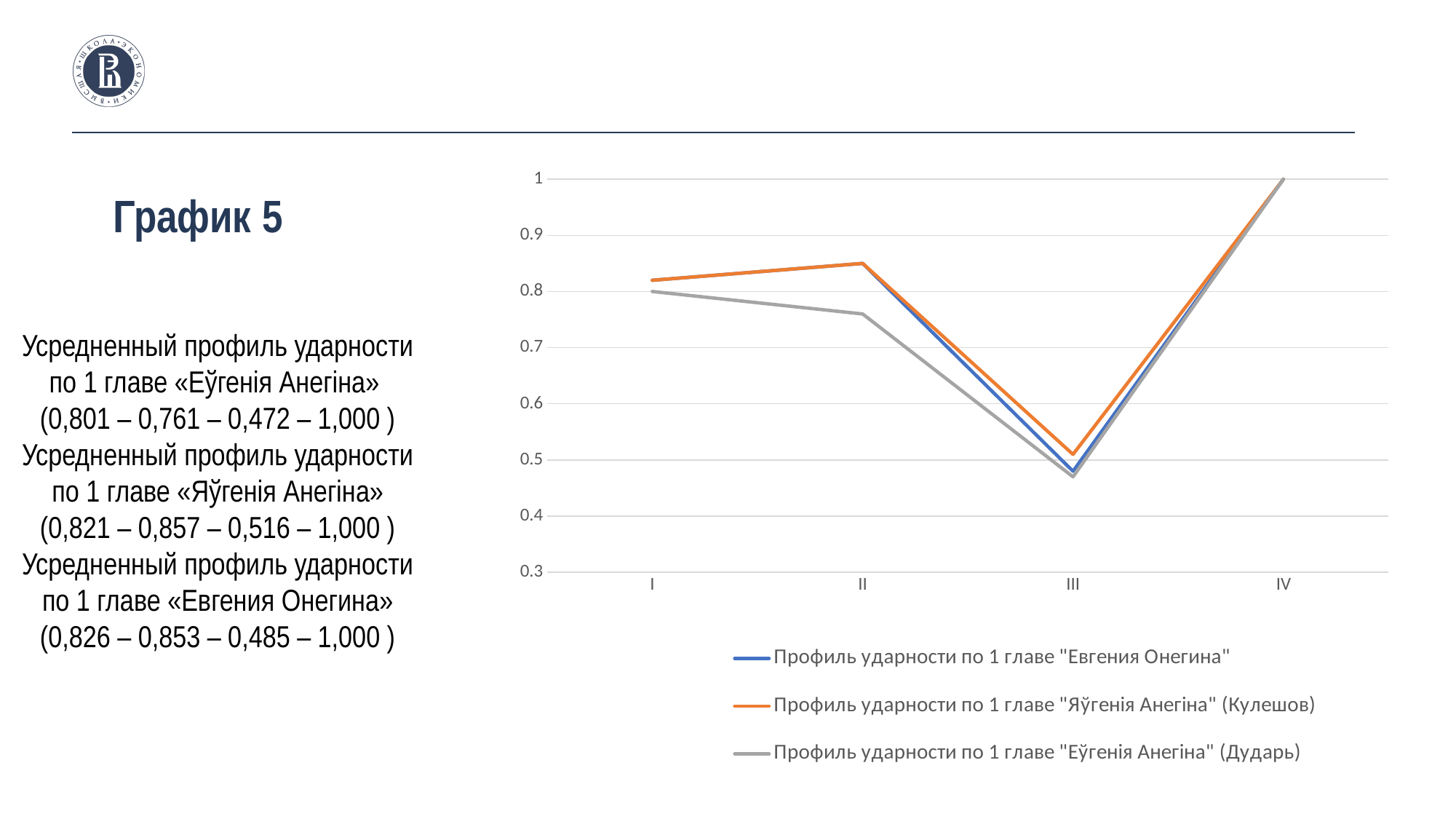
How many series does the legend list? 3 What value do all three series reach at point IV? 1 What colour is the line for the series "Профиль ударности по 1 главе "Яўгенія Анегіна" (Кулешов)"? orange Is the value for the "Еўгенія Анегіна" (Дударь) series at point II greater or less than 0.8? less Do the series values rise or fall from point III to point IV? rise How many points are there along the x axis of the chart? 4 At which x-axis point does the series "Профиль ударности по 1 главе "Яўгенія Анегіна" (Кулешов)" reach its lowest value? III What kind of chart is shown on the slide? line chart At which x-axis point does the series "Профиль ударности по 1 главе "Еўгенія Анегіна" (Дударь)" reach its highest value? IV At point II, which series is higher: "Яўгенія Анегіна" (Кулешов) or "Еўгенія Анегіна" (Дударь)? Яўгенія Анегіна (Кулешов) According to the values printed on the slide, what is the value of the averaged profile for «Еўгенія Анегіна» at point III? 0,472 Is the value for the "Яўгенія Анегіна" (Кулешов) series at point III greater or less than 0.6? less